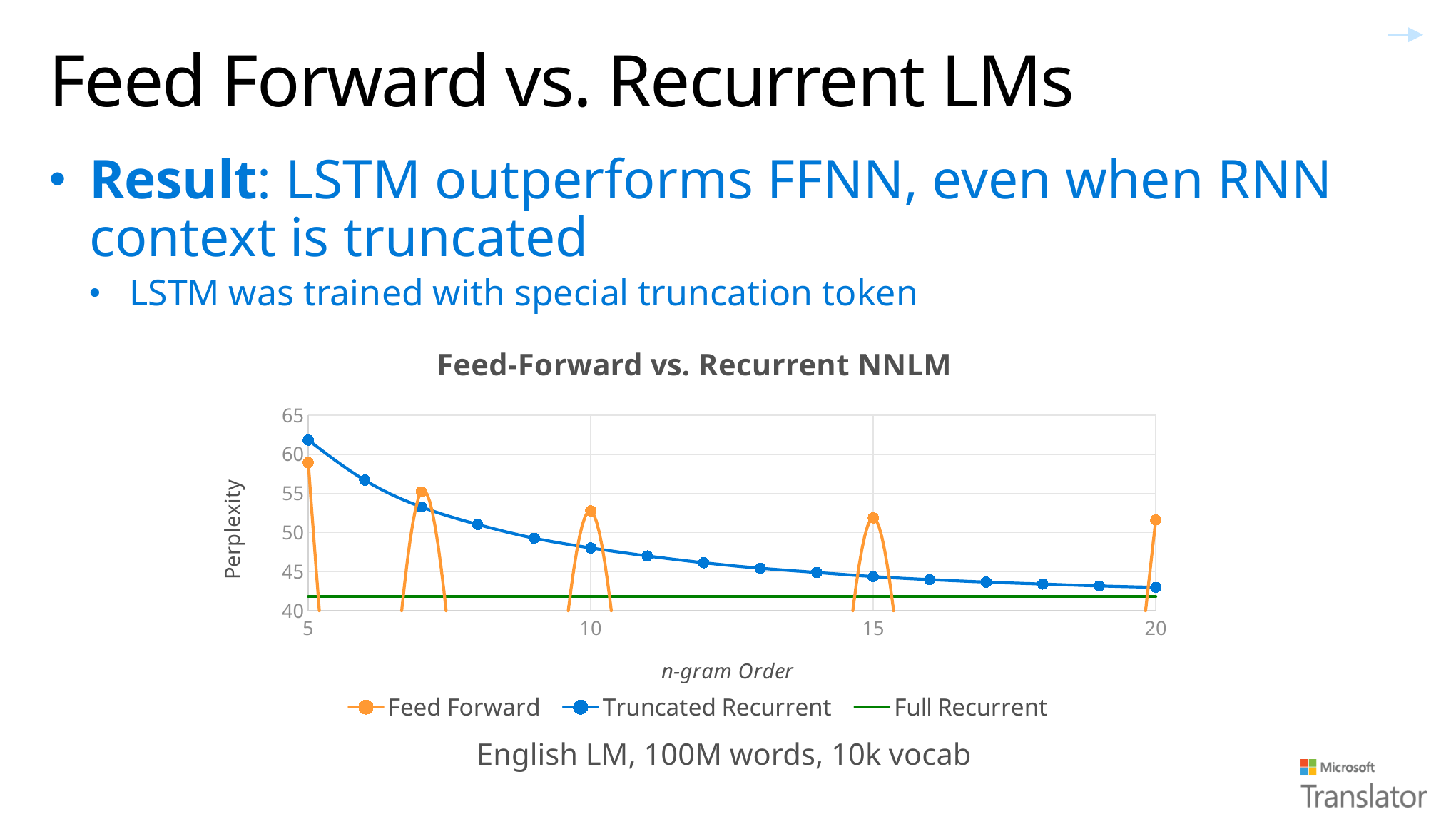
What is the title of the chart? Feed-Forward vs. Recurrent NNLM Is the Truncated Recurrent perplexity at n-gram order 5 greater or less than 60? greater What is the label of the y axis? Perplexity Does the Truncated Recurrent perplexity rise or fall as n-gram order increases? fall How many series does the legend list? 3 What kind of chart is shown on the slide? line chart At which n-gram order is the Truncated Recurrent perplexity lowest? 20 How many data points are plotted for the Truncated Recurrent series? 16 Is the Full Recurrent perplexity greater or less than 45? less At n-gram order 10, which series has the higher perplexity, Feed Forward or Truncated Recurrent? Feed Forward At which n-gram order is the Truncated Recurrent perplexity highest? 5 How many data points are plotted for the Feed Forward series? 5